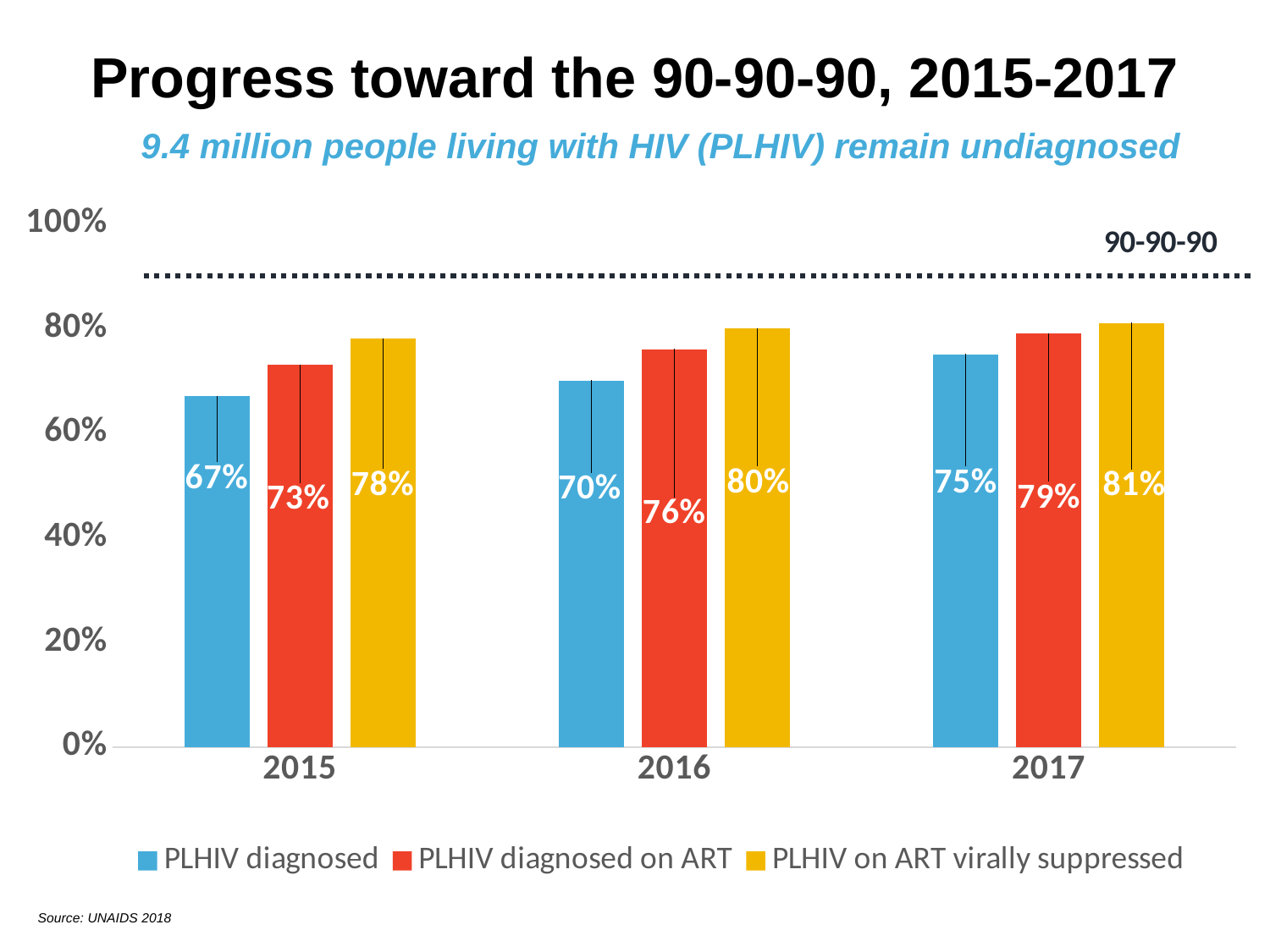
In which year is the value for PLHIV on ART virally suppressed lowest? 2015 Does the value for PLHIV diagnosed on ART rise or fall from 2015 to 2017? Rise What is the value for PLHIV diagnosed in 2015? 67% How many years are shown on the x axis? 3 How many series does the legend list? 3 Which is larger: PLHIV diagnosed on ART in 2015 or PLHIV diagnosed in 2016? PLHIV diagnosed on ART in 2015 Is the value for PLHIV on ART virally suppressed in 2016 greater or less than 60%? greater In which year is the value for PLHIV diagnosed highest? 2017 What is the value for PLHIV diagnosed on ART in 2016? 76% What is the value for PLHIV on ART virally suppressed in 2017? 81% What kind of chart is shown on the slide? Bar chart What is the difference between PLHIV diagnosed in 2017 and PLHIV diagnosed in 2015? 8%